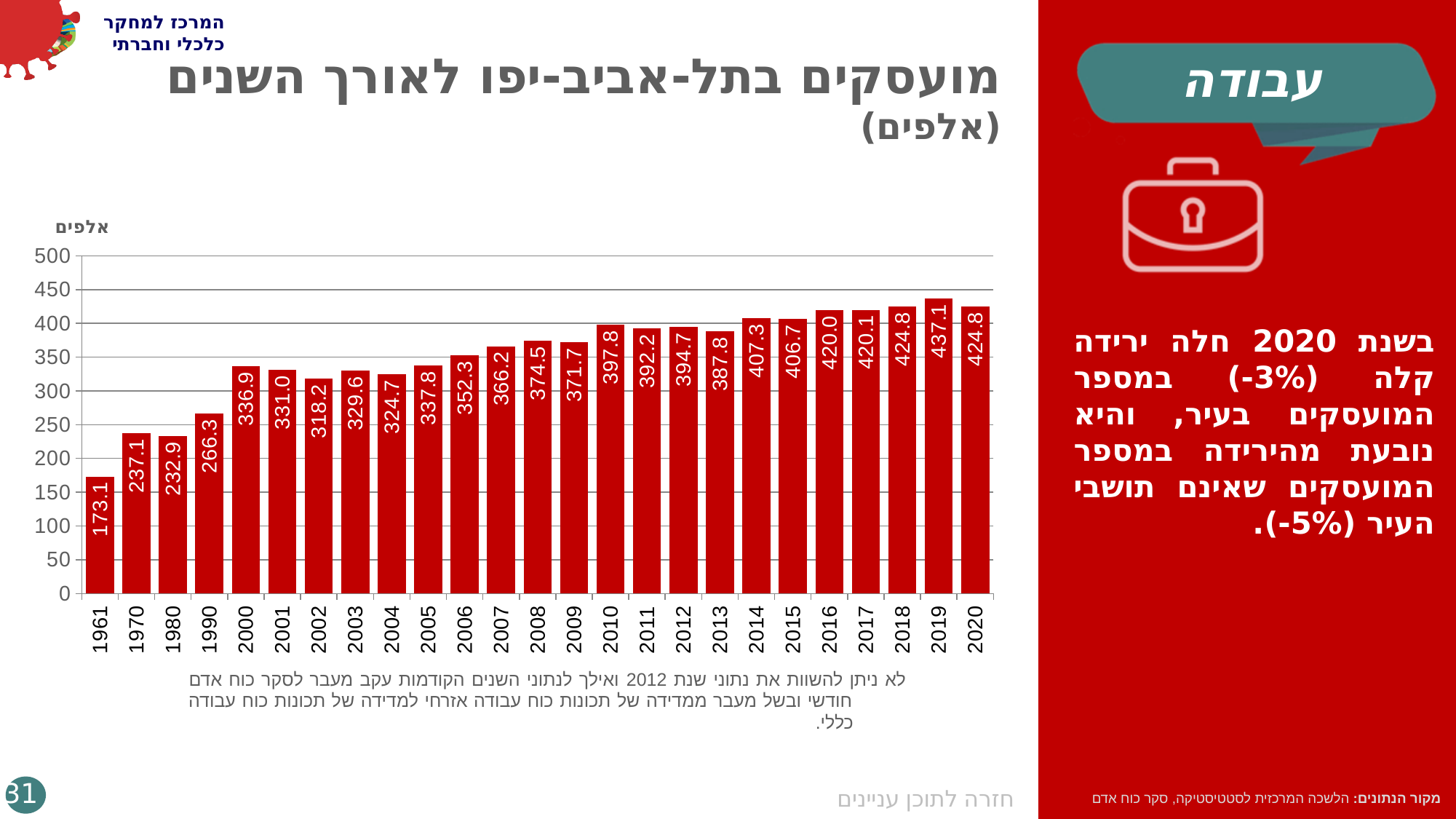
What is the value for 2020? 424.8 Which is larger, the value for 2008 or the value for 2009? 2008 What is the difference between the values for 2019 and 2020? 12.3 How many years are shown on the x axis? 25 Do the values generally rise or fall from 1961 to 2019? rise Which year has the highest value? 2019 What is the value for 2010? 397.8 Which year has the lowest value? 1961 What is the value for 1961? 173.1 Is the value for 2002 greater or less than 300? greater What kind of chart is this? bar chart What is the difference between the values for 2000 and 1990? 70.6